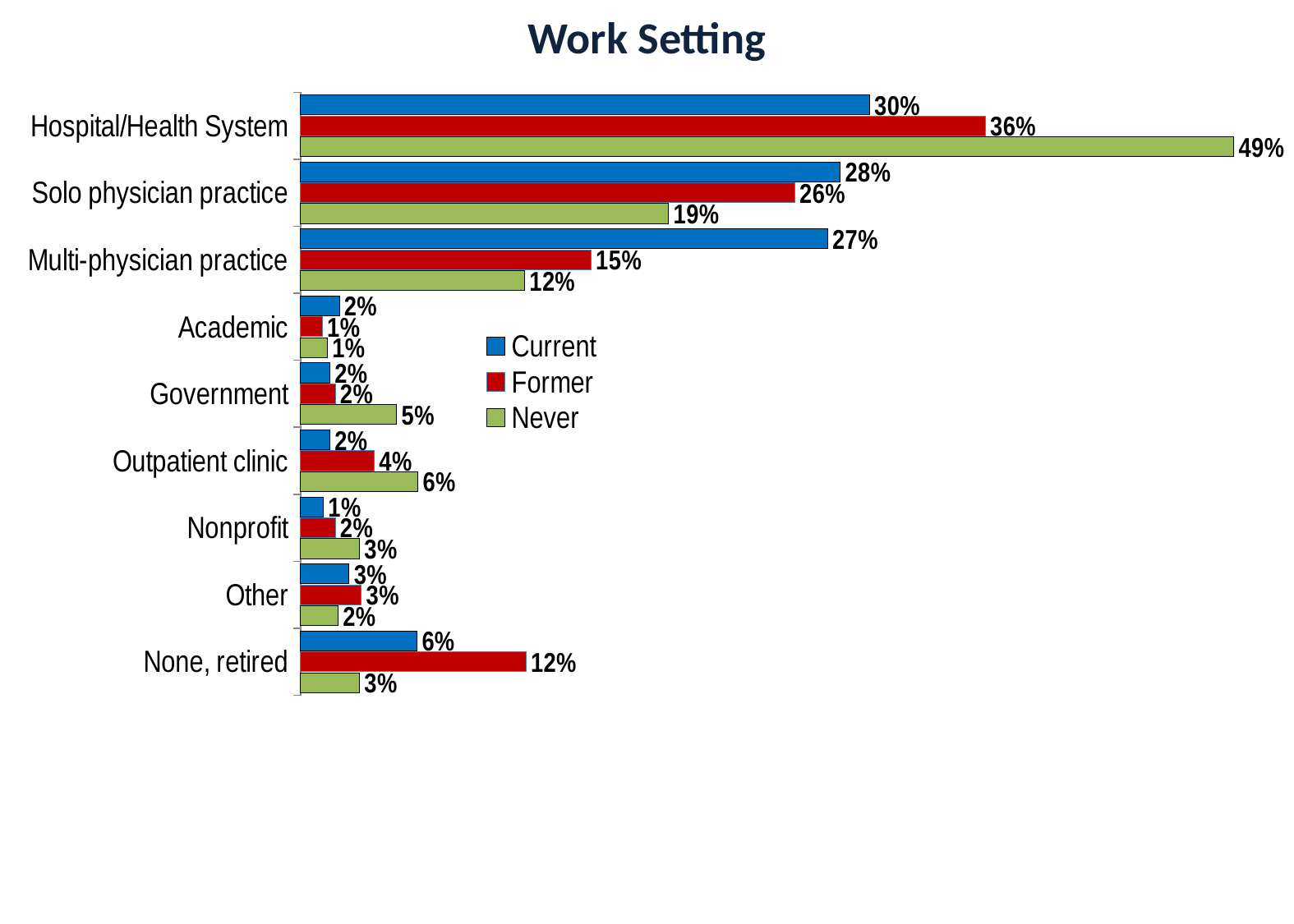
What kind of chart is this? Bar chart How many categories are shown on the chart? 9 What is the difference between the Former and Current values for Hospital/Health System? 6% What is the title of the chart? Work Setting Which category has the lowest Current value? Nonprofit Which is larger for Solo physician practice, the Current value or the Never value? Current What is the Former value for None, retired? 12% Which category has the highest Never value? Hospital/Health System What is the Current value for Multi-physician practice? 27% What is the Never value for Hospital/Health System? 49% How many series does the legend list? 3 Which series is shown in green? Never